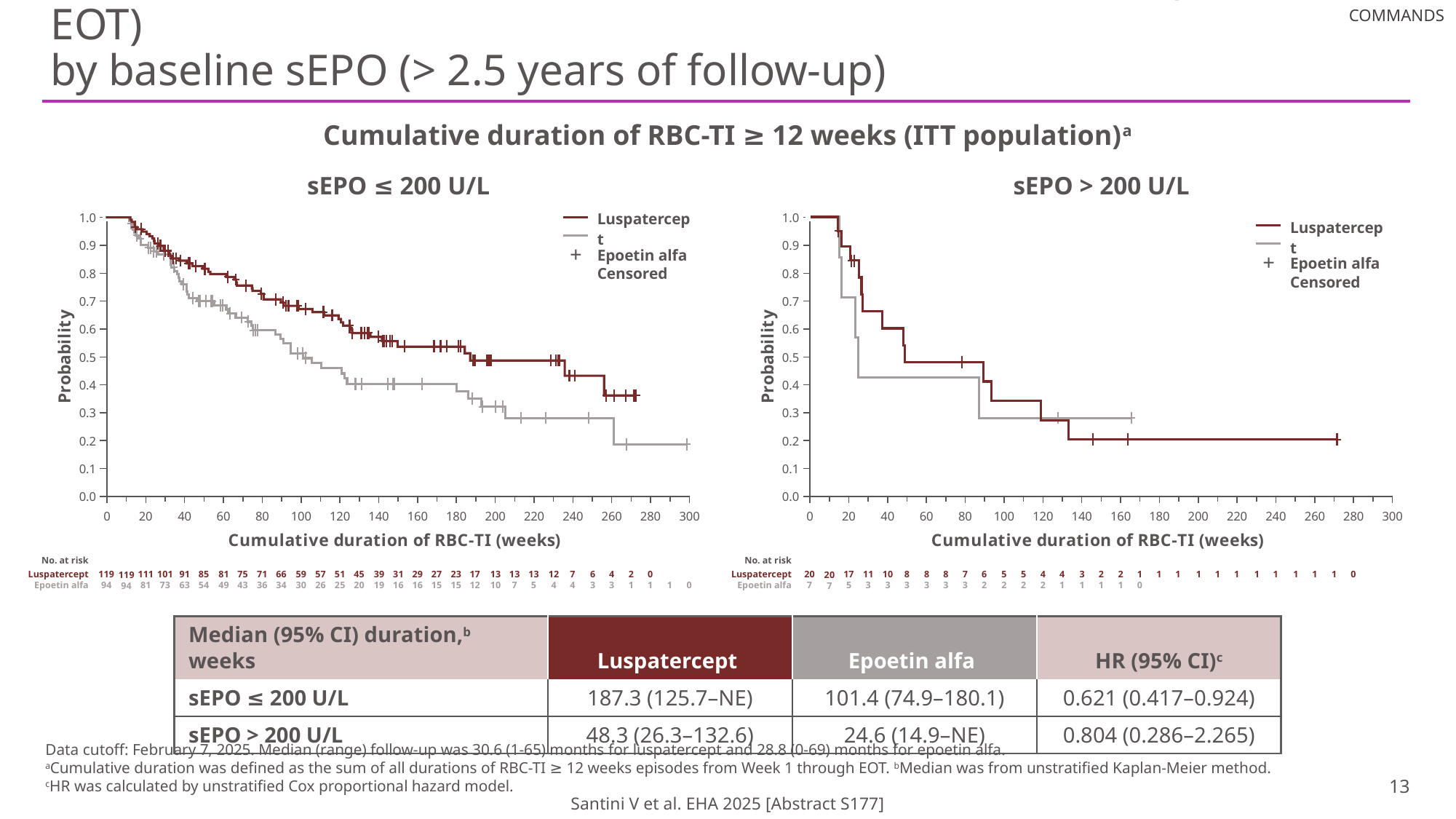
In the sEPO ≤ 200 U/L chart, which curve is higher at 100 weeks, Luspatercept or Epoetin alfa? Luspatercept In the sEPO ≤ 200 U/L chart, does the Luspatercept probability rise or fall as cumulative duration increases? fall How many Kaplan-Meier panels are shown on the slide? 2 Which two treatment groups are listed in the legend of the sEPO > 200 U/L chart? Luspatercept and Epoetin alfa In the sEPO > 200 U/L chart, is the Luspatercept probability at 100 weeks greater or less than 0.4? less In the sEPO > 200 U/L chart, how many Luspatercept patients are at risk at week 0? 20 In the sEPO ≤ 200 U/L chart, how many Luspatercept patients are at risk at week 0? 119 What kind of chart is the sEPO ≤ 200 U/L panel? line chart (Kaplan-Meier curve) In the sEPO ≤ 200 U/L chart, how many Epoetin alfa patients are at risk at week 0? 94 In the sEPO > 200 U/L chart, how many Epoetin alfa patients are at risk at week 0? 7 In the sEPO ≤ 200 U/L chart, is the Luspatercept probability at 100 weeks greater or less than 0.6? greater In the sEPO ≤ 200 U/L chart, is the Epoetin alfa probability at 100 weeks greater or less than 0.6? less